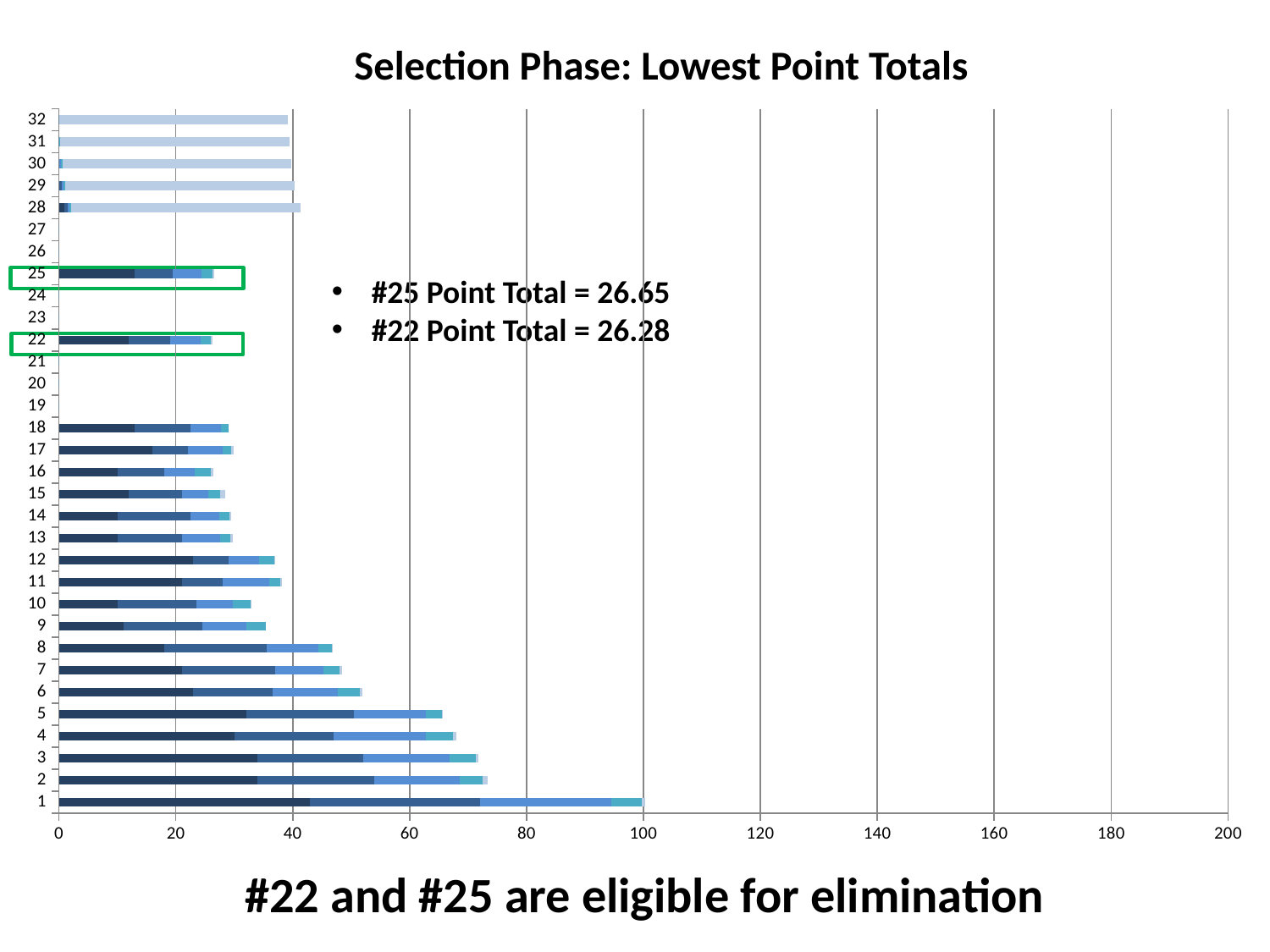
Which two categories are outlined with green boxes on the chart? 22 and 25 Is the total bar length for category 5 greater or less than 60? greater Which has the lower point total, #22 or #25? #22 How many categories are listed on the vertical axis of the chart? 32 What kind of chart is shown on the slide? bar chart What is the title of the chart? Selection Phase: Lowest Point Totals Which category has the longest bar in the chart? 1 Is the total bar length for category 18 greater or less than 40? less What is the difference between the point totals of #25 and #22? 0.37 Is the total bar length for category 1 greater or less than 80? greater What is the point total for #25 according to the slide? 26.65 What is the point total for #22 according to the slide? 26.28